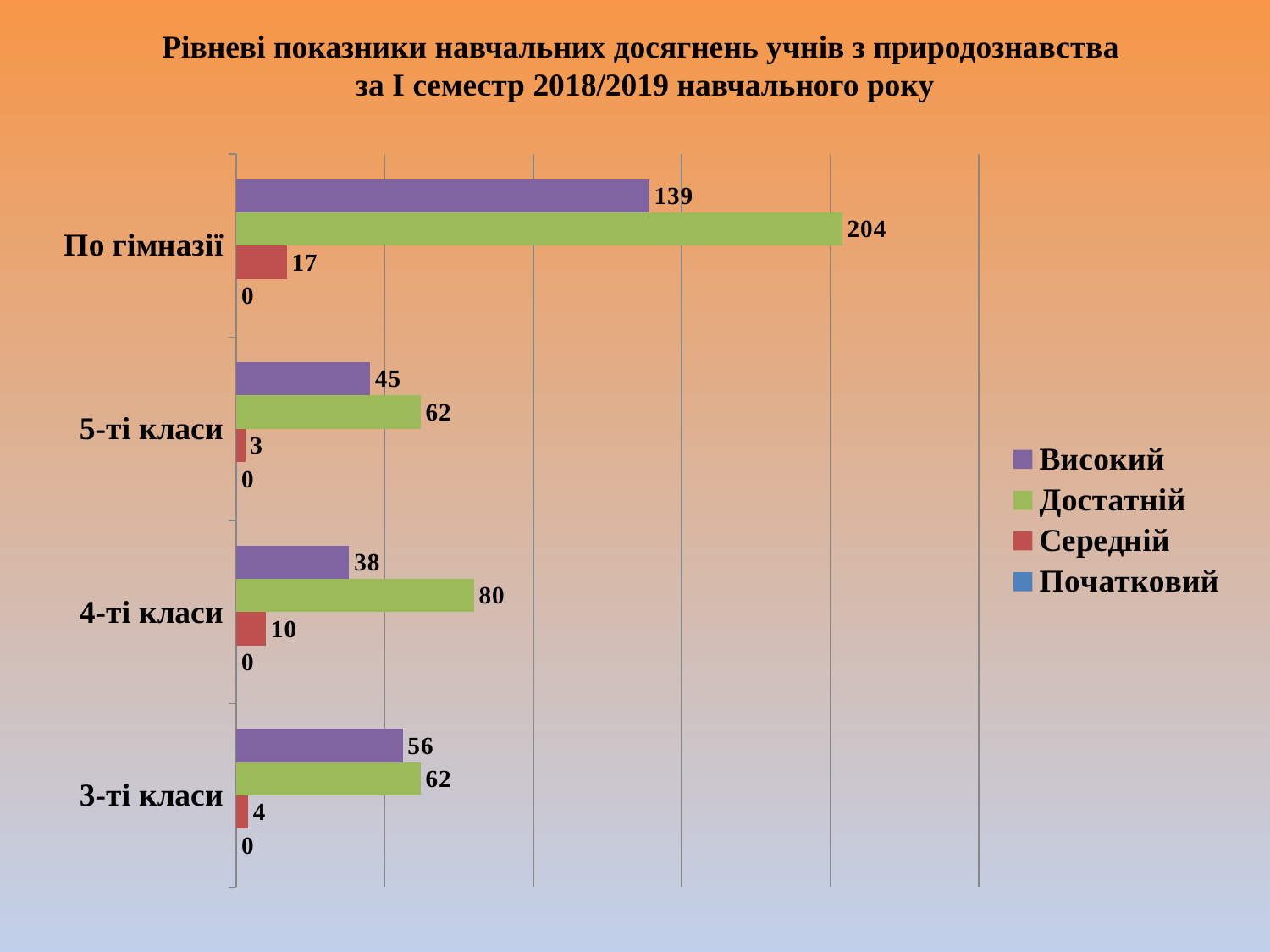
How many categories are shown on the chart? 4 What kind of chart is shown on the slide? bar chart Which is larger: the Високий value for 3-ті класи or the Високий value for 4-ті класи? 3-ті класи What is the value of Високий for 5-ті класи? 45 Which series is shown in green in the legend? Достатній How many series does the legend list? 4 Which category has the highest Високий value? По гімназії What is the value of Середній for 4-ті класи? 10 Among the class categories (excluding По гімназії), which has the lowest Середній value? 5-ті класи What is the value of Достатній for По гімназії? 204 What is the value of Початковий for 3-ті класи? 0 What is the difference between the Достатній and Високий values for По гімназії? 65